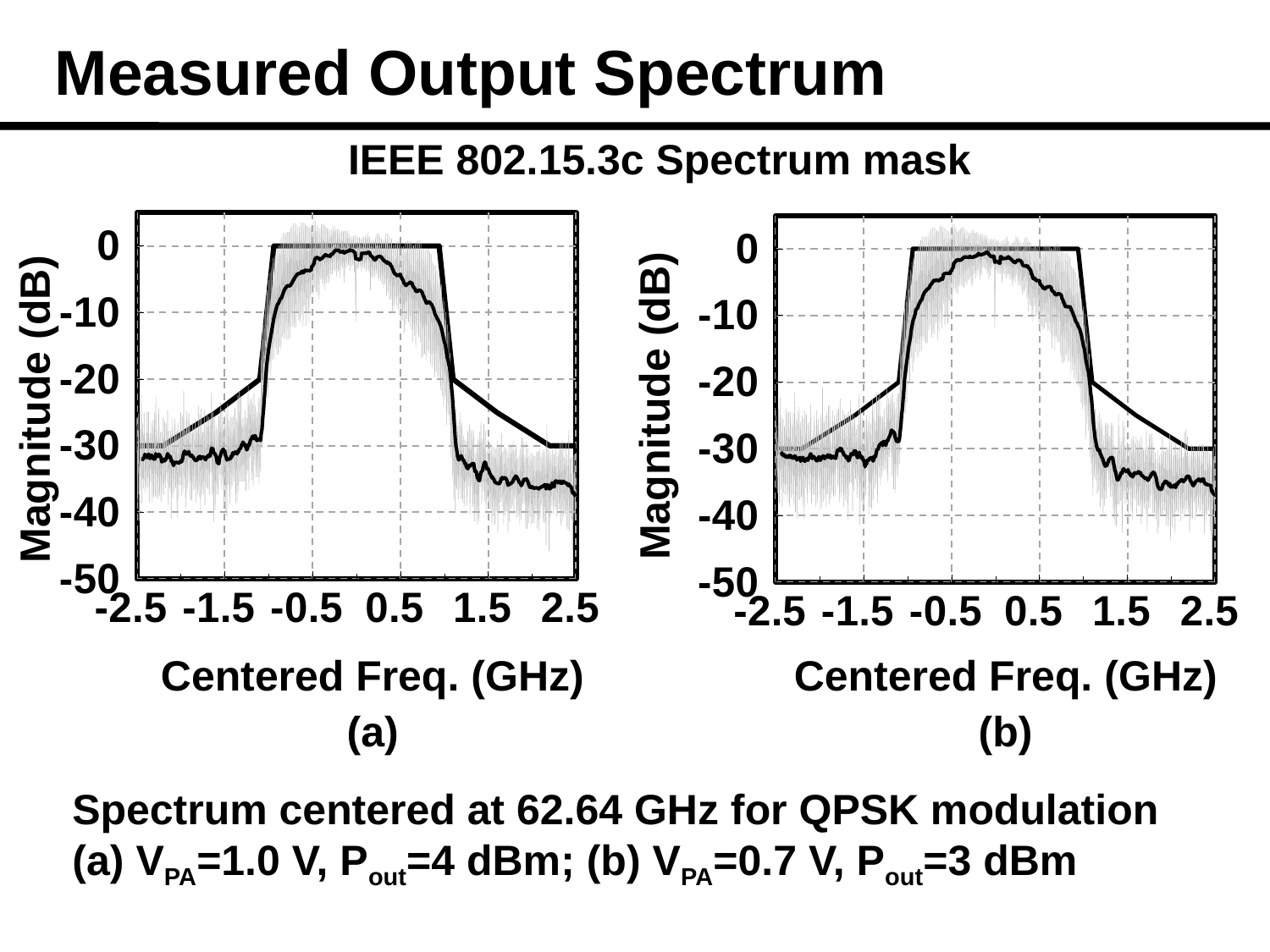
In chart (b), is the measured spectrum at 2.5 GHz greater or less than -20 dB? less In chart (a), what is the level of the spectrum mask at 0 GHz centered frequency? 0 In chart (b), what is the highest value labeled on the x-axis? 2.5 How many labeled tick values are on the x-axis of chart (a)? 6 In chart (a), is the measured spectrum at 0 GHz greater or less than -10 dB? greater In chart (b), does the measured spectrum rise or fall as the centered frequency goes from 0 GHz to 1.5 GHz? fall In chart (b), what is the level of the spectrum mask at 2.5 GHz centered frequency? -30 What is the x-axis label of chart (b)? Centered Freq. (GHz) What kind of chart is shown in panel (a)? line chart How many charts are shown on the slide? 2 What is the y-axis label of chart (a)? Magnitude (dB) In chart (a), what is the lowest value shown on the y-axis? -50